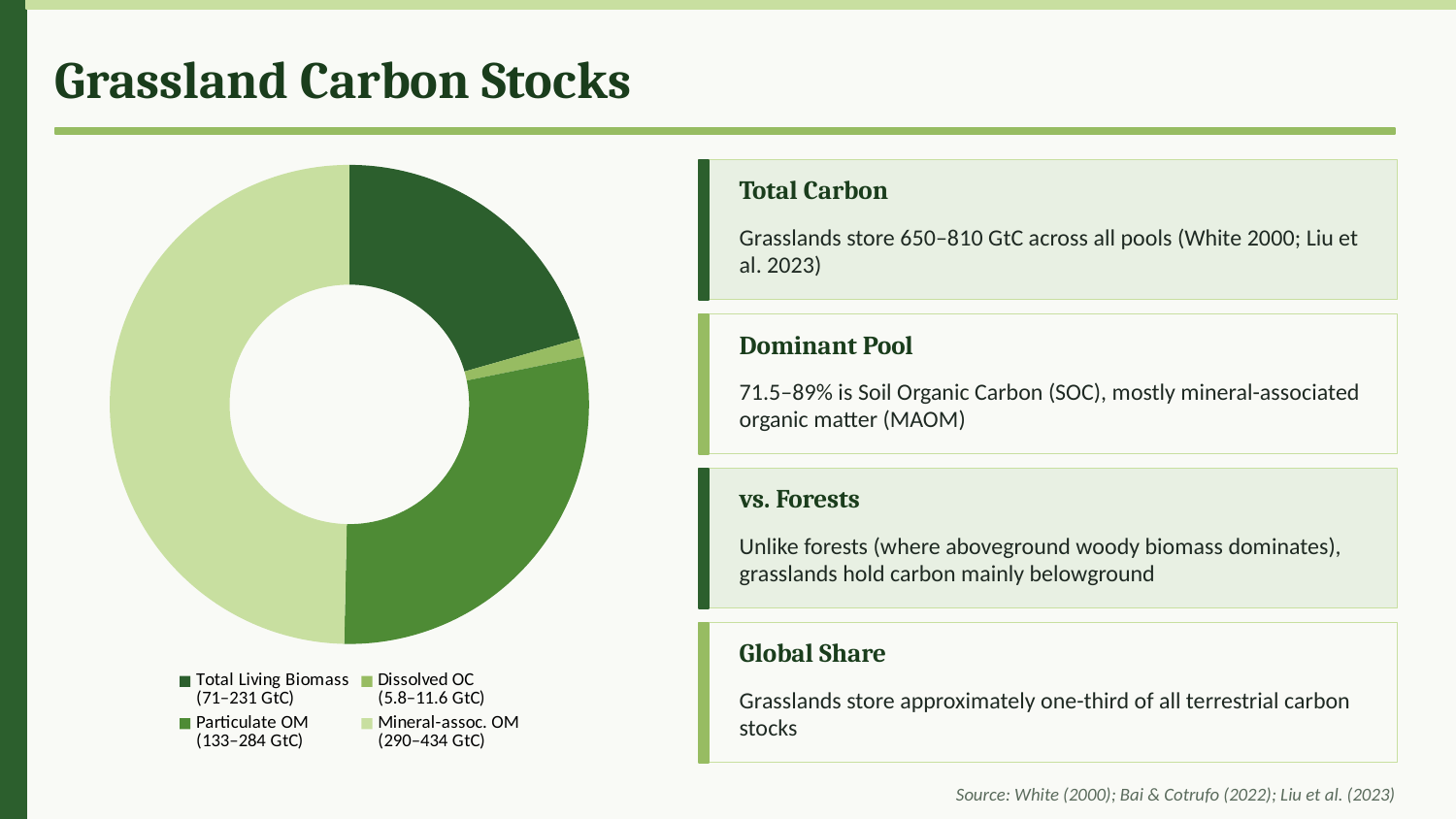
How many categories does the doughnut chart show? 4 What range in GtC does the legend give for Particulate OM? 133–284 GtC Which occupies a larger portion of the doughnut chart, Mineral-assoc. OM or Total Living Biomass? Mineral-assoc. OM What range in GtC does the legend give for Total Living Biomass? 71–231 GtC What kind of chart is shown on the slide? Doughnut chart Which occupies a larger portion of the doughnut chart, Particulate OM or Dissolved OC? Particulate OM Which category occupies the smallest portion of the doughnut chart? Dissolved OC Which category occupies the largest portion of the doughnut chart? Mineral-assoc. OM What range in GtC does the legend give for Dissolved OC? 5.8–11.6 GtC What range in GtC does the legend give for Mineral-assoc. OM? 290–434 GtC Which category is shown in the lightest green in the doughnut chart? Mineral-assoc. OM What is the title of the slide containing the doughnut chart? Grassland Carbon Stocks